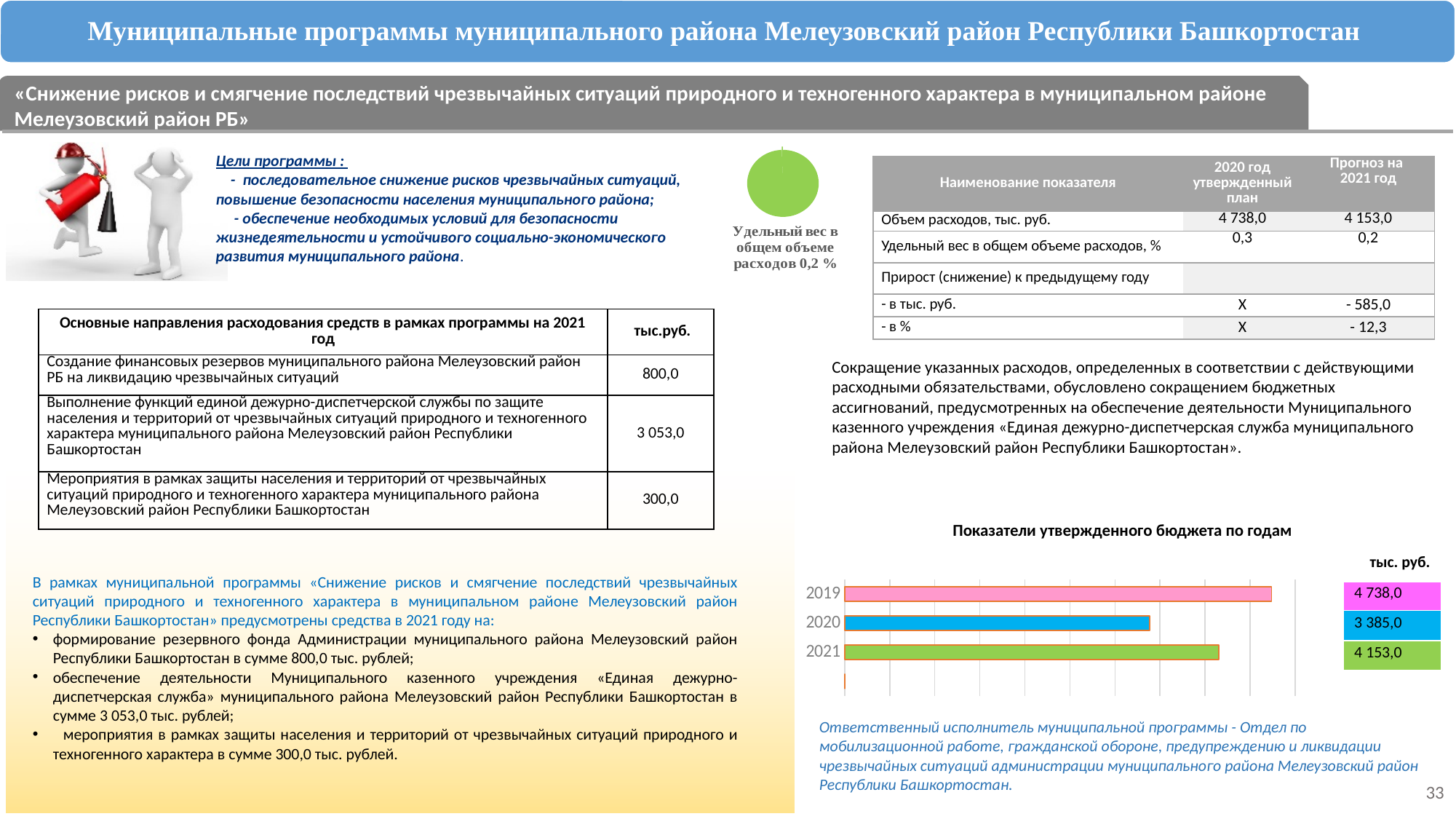
What share is stated in the caption of the green pie chart at the top of the slide? 0,2 % What kind of chart is 'Показатели утвержденного бюджета по годам'? bar chart In the bar chart 'Показатели утвержденного бюджета по годам', which year has the highest value? 2019 In the bar chart 'Показатели утвержденного бюджета по годам', which year has the larger value, 2020 or 2021? 2021 In the bar chart 'Показатели утвержденного бюджета по годам', what is the difference between the values for 2019 and 2021? 585,0 In the bar chart 'Показатели утвержденного бюджета по годам', what is the value for 2019? 4 738,0 In the bar chart 'Показатели утвержденного бюджета по годам', what is the value for 2021? 4 153,0 In the bar chart 'Показатели утвержденного бюджета по годам', which year has the lowest value? 2020 What unit is indicated for the values in the bar chart 'Показатели утвержденного бюджета по годам'? тыс. руб. In the bar chart 'Показатели утвержденного бюджета по годам', what is the value for 2020? 3 385,0 In the bar chart 'Показатели утвержденного бюджета по годам', what is the difference between the values for 2021 and 2020? 768,0 How many years are shown in the bar chart 'Показатели утвержденного бюджета по годам'? 3